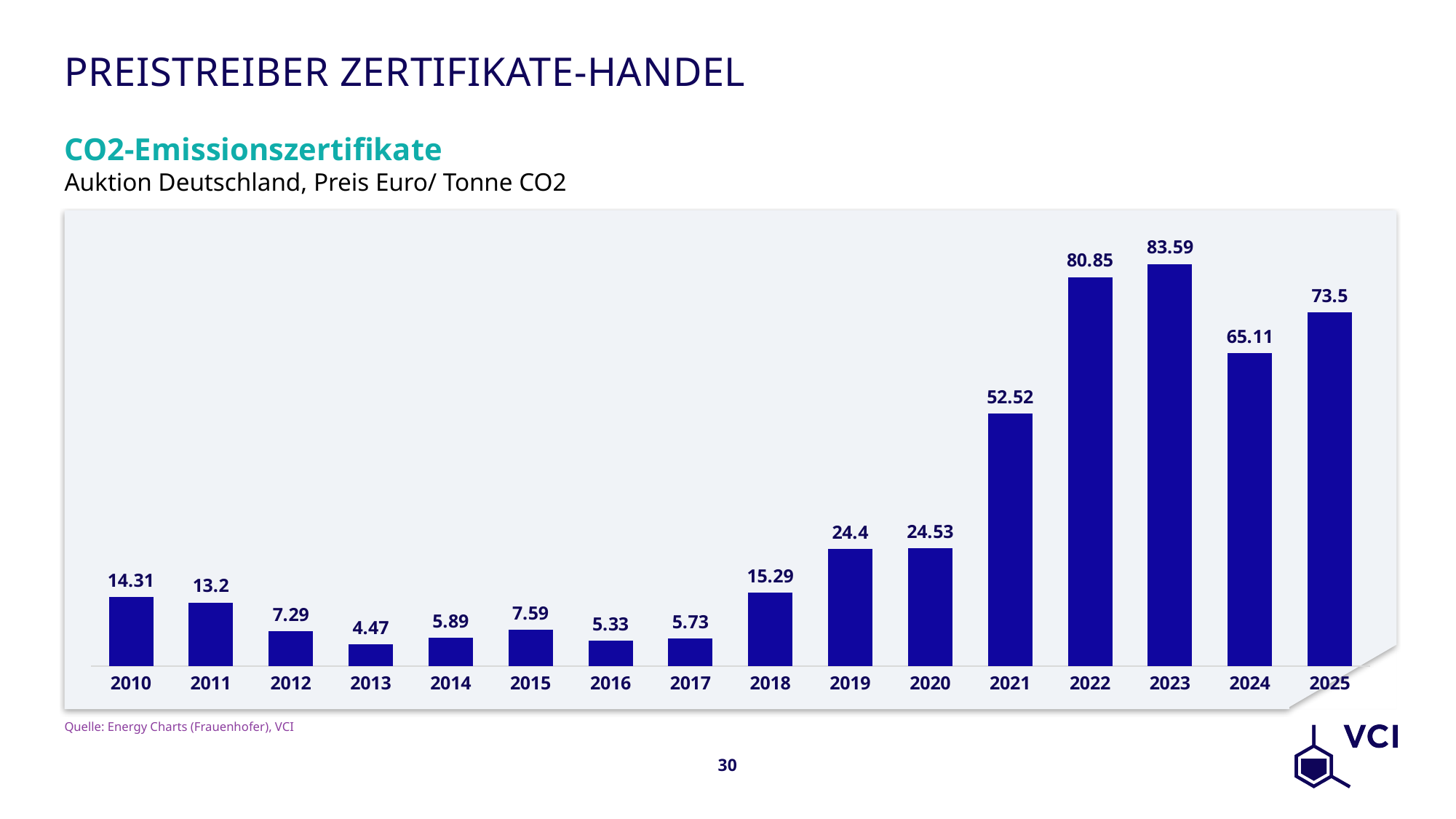
What is the value shown for 2025? 73.5 Which year has the lowest value? 2013 What is the CO2 certificate price shown for 2021? 52.52 Which is larger, the value for 2024 or the value for 2025? 2025 Which year has the highest value? 2023 What value is shown for 2013? 4.47 What is the source given below the chart? Energy Charts (Frauenhofer), VCI How many years are shown on the x axis? 16 What is the difference between the values for 2023 and 2024? 18.48 What is the difference between the values for 2022 and 2021? 28.33 Which is larger, the value for 2010 or the value for 2011? 2010 What kind of chart is shown on the slide? bar chart